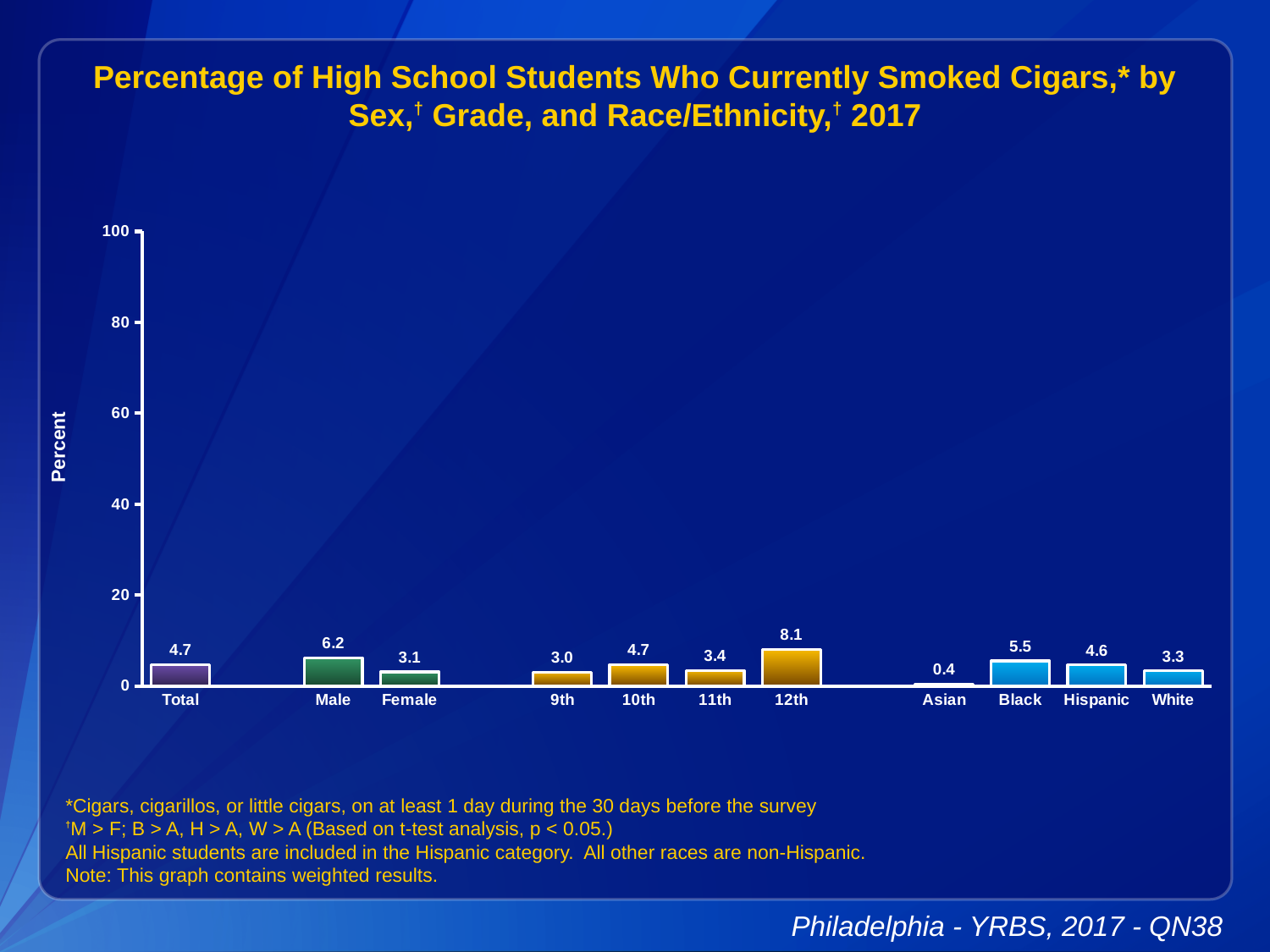
What is the value for 12th grade? 8.1 What is the value for Total? 4.7 What is the difference between the values for Male and Female? 3.1 Which category has the highest value? 12th What kind of chart is this? bar chart What is the value for Asian? 0.4 Which is larger, the value for Black or the value for Hispanic? Black What is the label of the y axis? Percent How many categories are shown on the x axis? 11 Which category has the lowest value? Asian What is the value for Male? 6.2 Is the value for 12th grade greater or less than 20? less